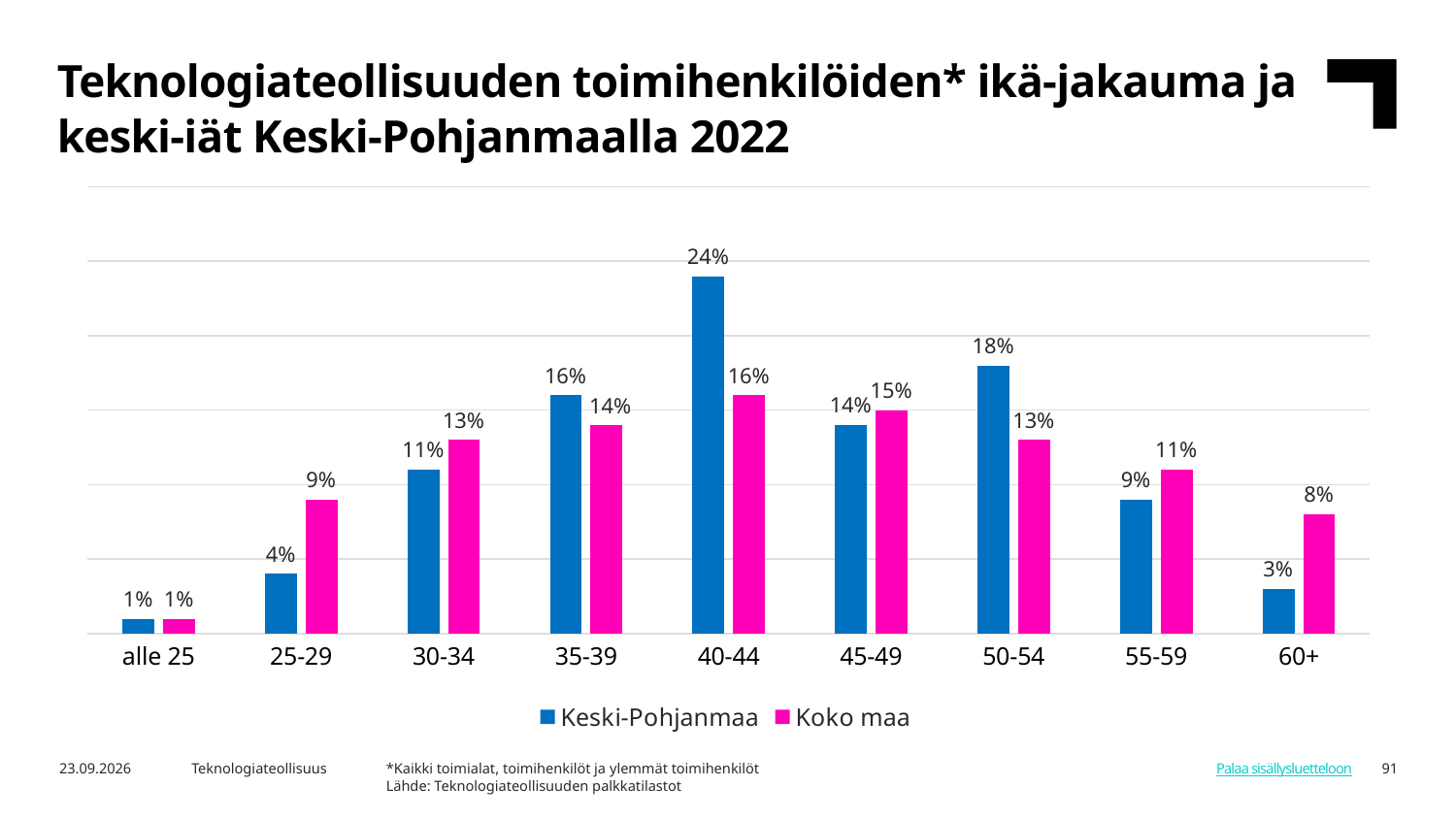
Which is larger in the 50-54 age group, Keski-Pohjanmaa or Koko maa? Keski-Pohjanmaa What is the value for Keski-Pohjanmaa in the 40-44 age group? 24% Which age group has the lowest value for Koko maa? alle 25 What is the difference between Keski-Pohjanmaa and Koko maa in the 40-44 age group? 8 percentage points What is the value for Keski-Pohjanmaa in the 60+ age group? 3% What is the value for Koko maa in the 25-29 age group? 9% How many age groups are shown on the x axis? 9 Which series is shown in pink in the legend? Koko maa What kind of chart is shown on the slide? Bar chart Which age group has the highest value for Keski-Pohjanmaa? 40-44 Which is larger in the 55-59 age group, Keski-Pohjanmaa or Koko maa? Koko maa How many series does the legend list? 2